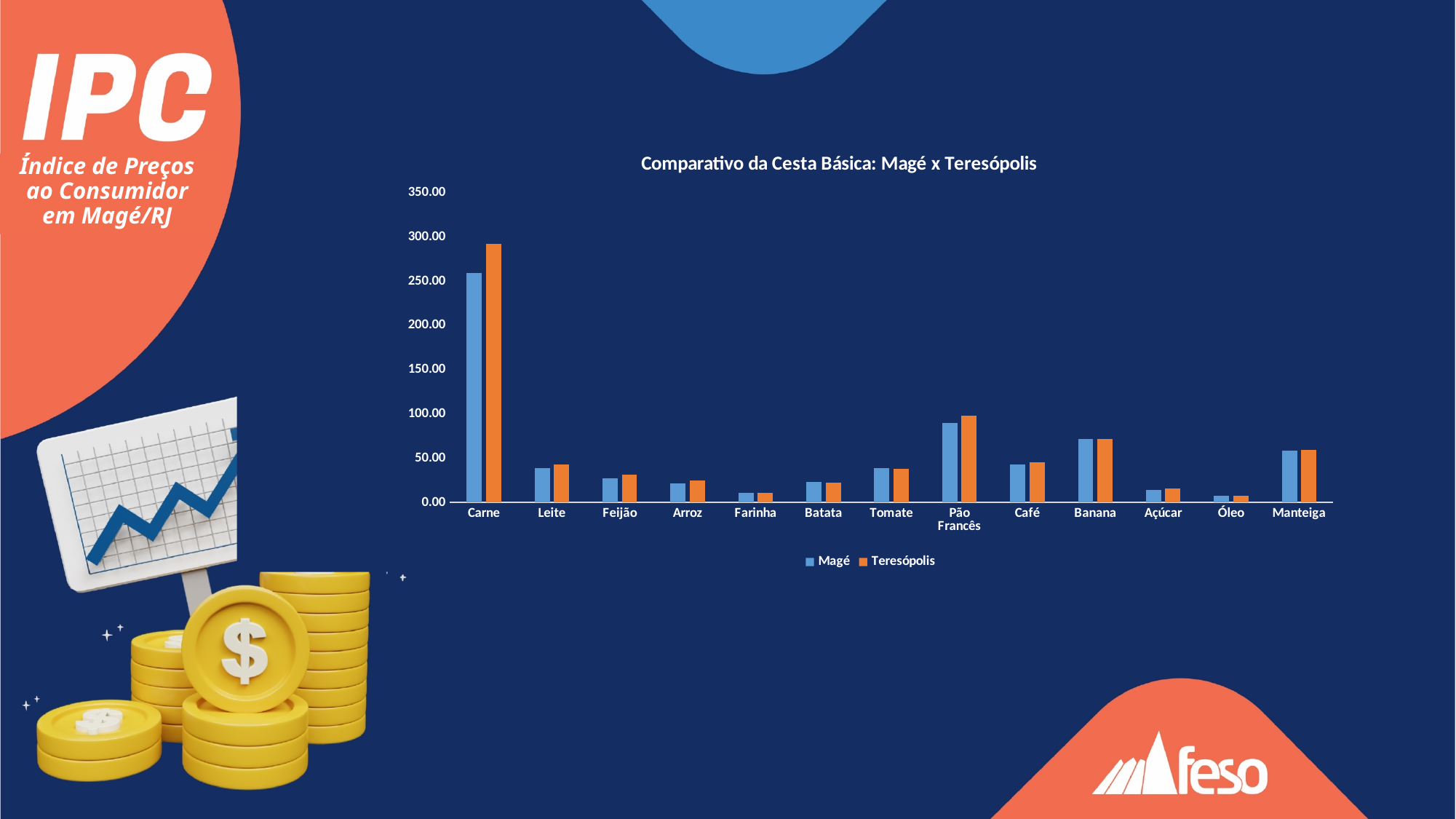
What kind of chart is shown on the slide? bar chart Which category has the lowest value for Magé? Óleo Is the Teresópolis value for Carne greater or less than 250.00? greater Is the Magé value for Pão Francês greater or less than 100.00? less How many series does the legend list? 2 How many product categories are shown on the x axis? 13 For Carne, which is larger: the Magé value or the Teresópolis value? Teresópolis Which category has the highest value for Magé? Carne Which colour represents the Teresópolis series in the legend? orange What is the title of the chart? Comparativo da Cesta Básica: Magé x Teresópolis Which category has the highest value for Teresópolis? Carne Is the Magé value for Carne greater or less than 200.00? greater